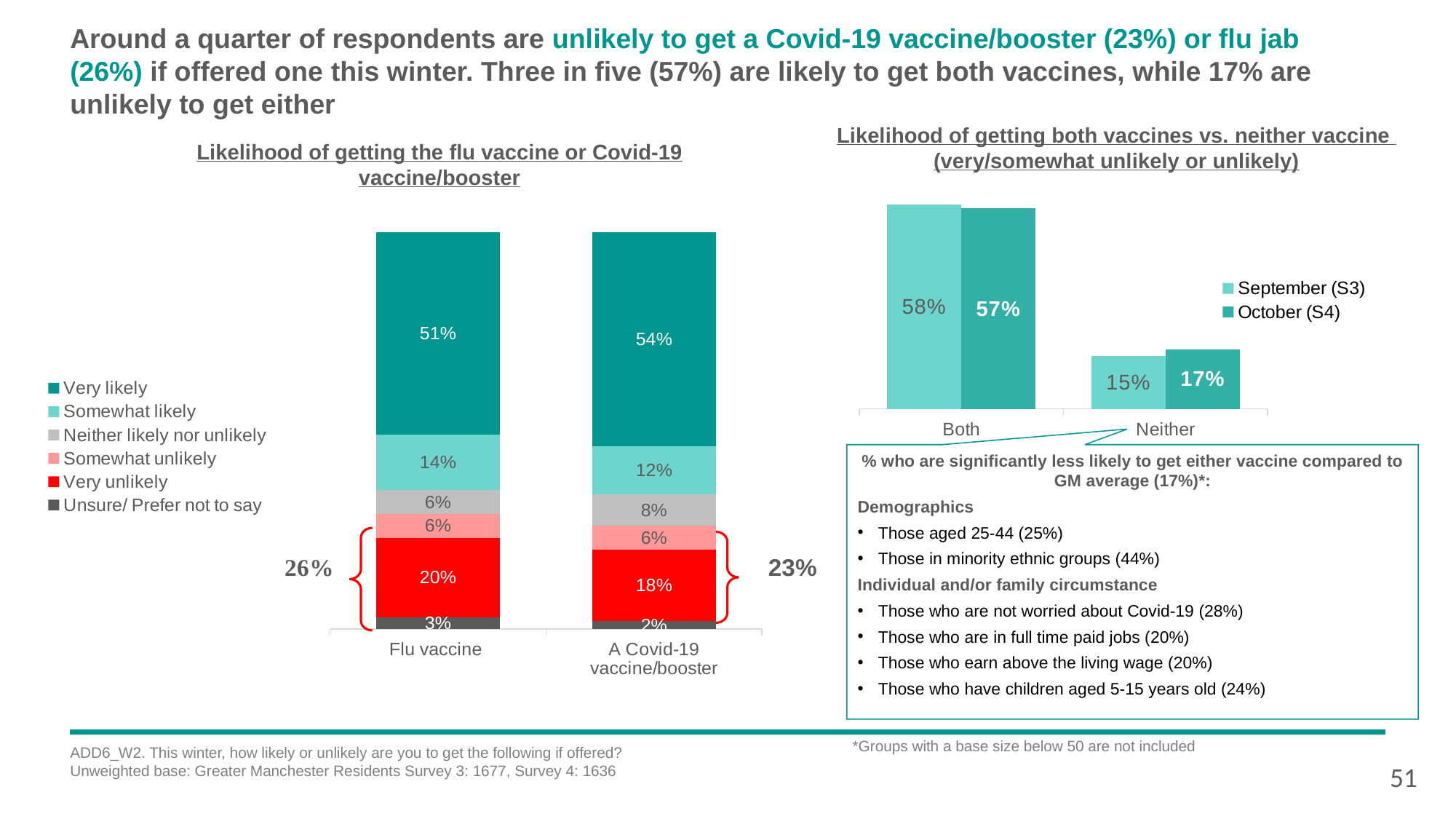
In the chart titled 'Likelihood of getting the flu vaccine or Covid-19 vaccine/booster', how many series does the legend list? 6 In the chart titled 'Likelihood of getting the flu vaccine or Covid-19 vaccine/booster', what is the difference between the 'Very likely' values for the Covid-19 vaccine/booster and the flu vaccine? 3% In the chart titled 'Likelihood of getting the flu vaccine or Covid-19 vaccine/booster', which has the larger 'Neither likely nor unlikely' value, the flu vaccine or the Covid-19 vaccine/booster? A Covid-19 vaccine/booster In the chart titled 'Likelihood of getting both vaccines vs. neither vaccine', how many series does the legend list? 2 In the chart titled 'Likelihood of getting both vaccines vs. neither vaccine', what is the difference between the October (S4) and September (S3) values for 'Neither'? 2% In the chart titled 'Likelihood of getting both vaccines vs. neither vaccine', what is the September (S3) value for 'Neither'? 15% In the chart titled 'Likelihood of getting the flu vaccine or Covid-19 vaccine/booster', what percentage are 'Very unlikely' to get a Covid-19 vaccine/booster? 18% What kind of chart is the one titled 'Likelihood of getting the flu vaccine or Covid-19 vaccine/booster'? Stacked bar chart In the chart titled 'Likelihood of getting the flu vaccine or Covid-19 vaccine/booster', what percentage are 'Very likely' to get the flu vaccine? 51% In the chart titled 'Likelihood of getting both vaccines vs. neither vaccine', which category has the highest value? Both In the chart titled 'Likelihood of getting both vaccines vs. neither vaccine', what is the October (S4) value for 'Both'? 57% In the chart titled 'Likelihood of getting the flu vaccine or Covid-19 vaccine/booster', what is the 'Somewhat likely' value for the flu vaccine? 14%